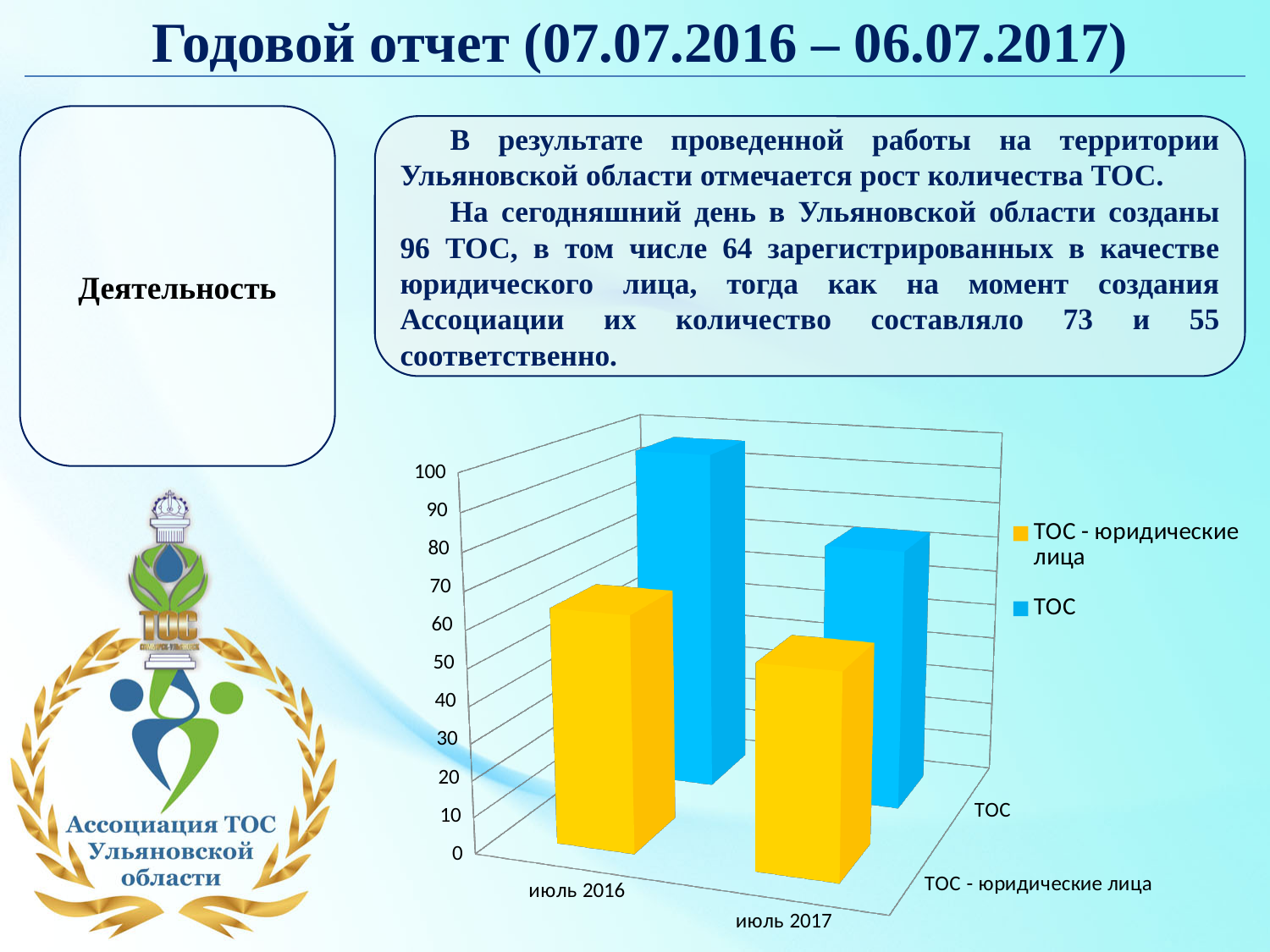
How many series does the chart legend list? 2 Is the value for ТОС in июль 2016 greater or less than 50? greater How many categories are shown along the x axis of the chart? 2 Which series in the chart is shown in yellow? ТОС - юридические лица What kind of chart is shown on the slide? bar chart Is the value for ТОС - юридические лица in июль 2016 greater or less than 20? greater What is the highest tick value shown on the vertical axis of the chart? 100 Which series in the chart is shown in blue? ТОС Is the value for ТОС - юридические лица in июль 2017 greater or less than 90? less